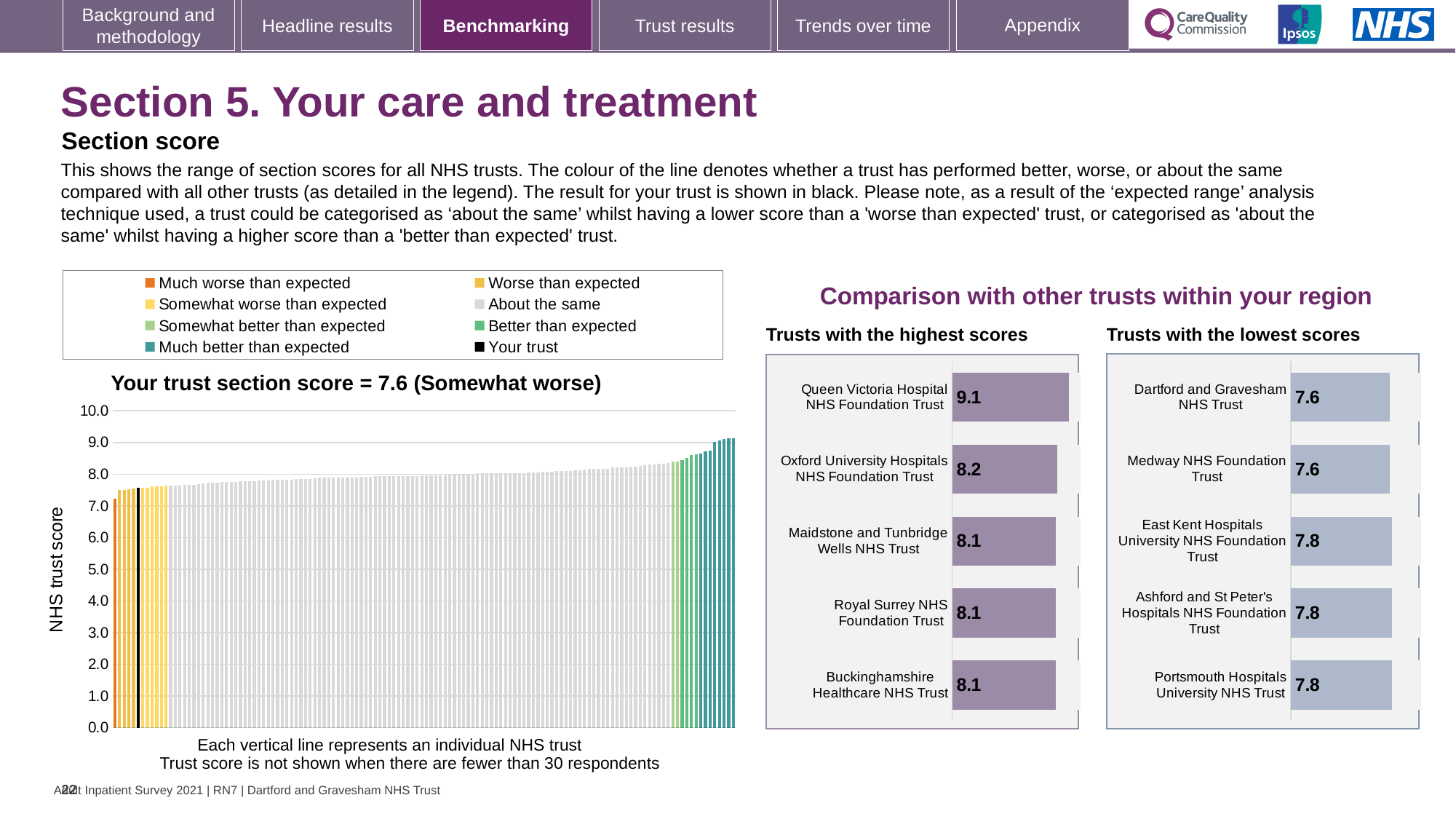
In the 'Trusts with the highest scores' chart, how many trusts are shown? 5 In the 'Your trust section score' chart, do the trust scores rise or fall from left to right along the x axis? Rise In the 'Trusts with the lowest scores' chart, what is the score for Medway NHS Foundation Trust? 7.6 In the 'Trusts with the highest scores' chart, what is the difference between the scores of Queen Victoria Hospital NHS Foundation Trust and Oxford University Hospitals NHS Foundation Trust? 0.9 In the 'Trusts with the highest scores' chart, what is the score for Queen Victoria Hospital NHS Foundation Trust? 9.1 In the 'Trusts with the lowest scores' chart, which is larger: the score for East Kent Hospitals University NHS Foundation Trust or Dartford and Gravesham NHS Trust? East Kent Hospitals University NHS Foundation Trust In the 'Your trust section score' chart, what is the section score for your trust? 7.6 What kind of chart is the 'Your trust section score' chart? Bar chart In the 'Trusts with the highest scores' chart, what is the score for Oxford University Hospitals NHS Foundation Trust? 8.2 In the 'Trusts with the highest scores' chart, which trust has the highest score? Queen Victoria Hospital NHS Foundation Trust In the 'Trusts with the lowest scores' chart, what is the score for Portsmouth Hospitals University NHS Trust? 7.8 In the 'Trusts with the lowest scores' chart, what is the difference between the scores of Ashford and St Peter's Hospitals NHS Foundation Trust and Dartford and Gravesham NHS Trust? 0.2